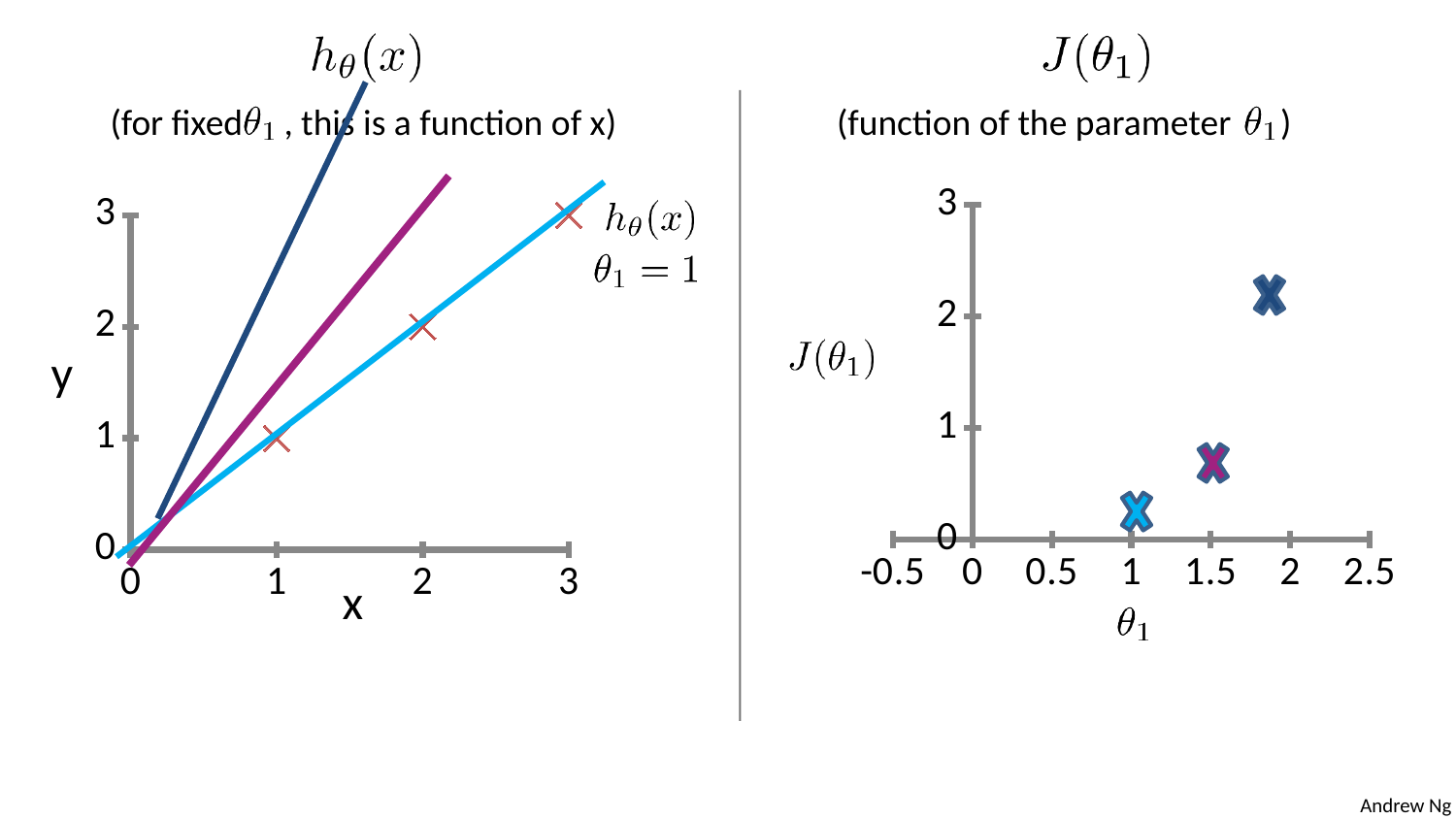
On the right chart titled J(θ1), how many X markers are plotted? 3 On the right chart titled J(θ1), is the value of the light blue X marker near θ1 = 1 greater or less than 1? less On the left chart titled h_θ(x), what is the y value of the data point at x = 3? 3 On the left chart titled h_θ(x), how many red data points (crosses) are plotted? 3 On the left chart titled h_θ(x), do the data points rise or fall as x increases? rise On the left chart titled h_θ(x), how many straight lines are drawn through the data? 3 On the left chart titled h_θ(x), which line is labelled θ1 = 1: the light blue, the magenta, or the dark blue line? the light blue line On the right chart titled J(θ1), which marker has the lowest J value: the light blue, the magenta, or the dark blue X? the light blue X On the left chart titled h_θ(x), what is the y value of the data point at x = 2? 2 On the right chart titled J(θ1), which marker has the highest J value: the light blue, the magenta, or the dark blue X? the dark blue X On the right chart titled J(θ1), is the value of the dark blue X marker near θ1 = 2 greater or less than 2? greater On the right chart titled J(θ1), do the plotted J values rise or fall as θ1 increases from 1 to 2? rise